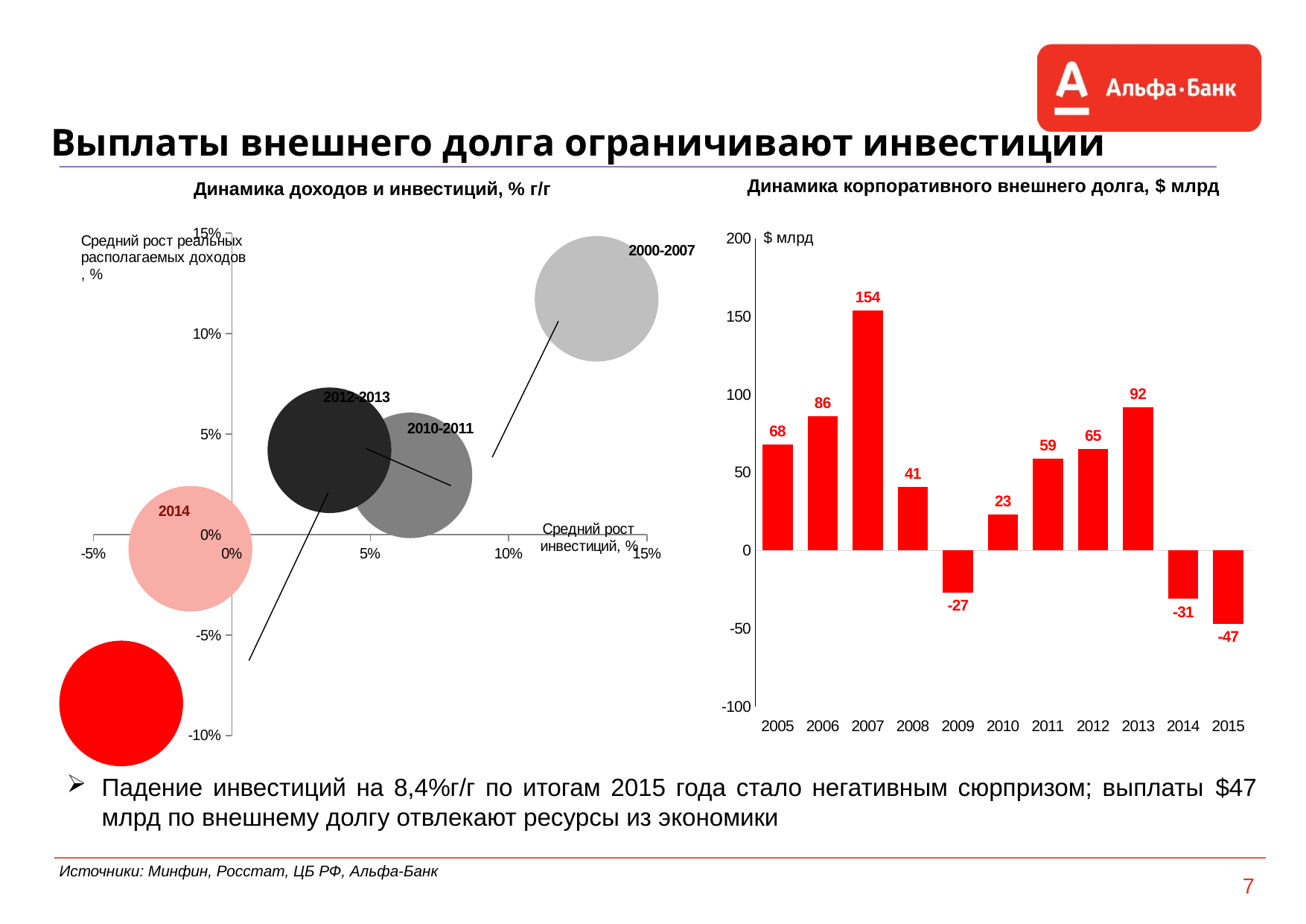
In the chart 'Динамика корпоративного внешнего долга, $ млрд', which year has the lowest value? 2015 In the chart 'Динамика корпоративного внешнего долга, $ млрд', which year has the highest value? 2007 In the chart 'Динамика корпоративного внешнего долга, $ млрд', how many years are shown on the x axis? 11 What kind of chart is 'Динамика доходов и инвестиций, % г/г'? bubble chart In the chart 'Динамика корпоративного внешнего долга, $ млрд', which is larger, the value for 2006 or the value for 2011? 2006 In the chart 'Динамика корпоративного внешнего долга, $ млрд', what is the difference between the values for 2013 and 2012? 27 What kind of chart is 'Динамика корпоративного внешнего долга, $ млрд'? bar chart In the chart 'Динамика корпоративного внешнего долга, $ млрд', do the values rise or fall from 2013 to 2015? fall In the chart 'Динамика корпоративного внешнего долга, $ млрд', what is the value for 2007? 154 In the chart 'Динамика доходов и инвестиций, % г/г', is the average real disposable income growth for the 2000-2007 bubble greater or less than 10%? greater In the chart 'Динамика корпоративного внешнего долга, $ млрд', what is the value for 2010? 23 In the chart 'Динамика корпоративного внешнего долга, $ млрд', what is the value for 2015? -47